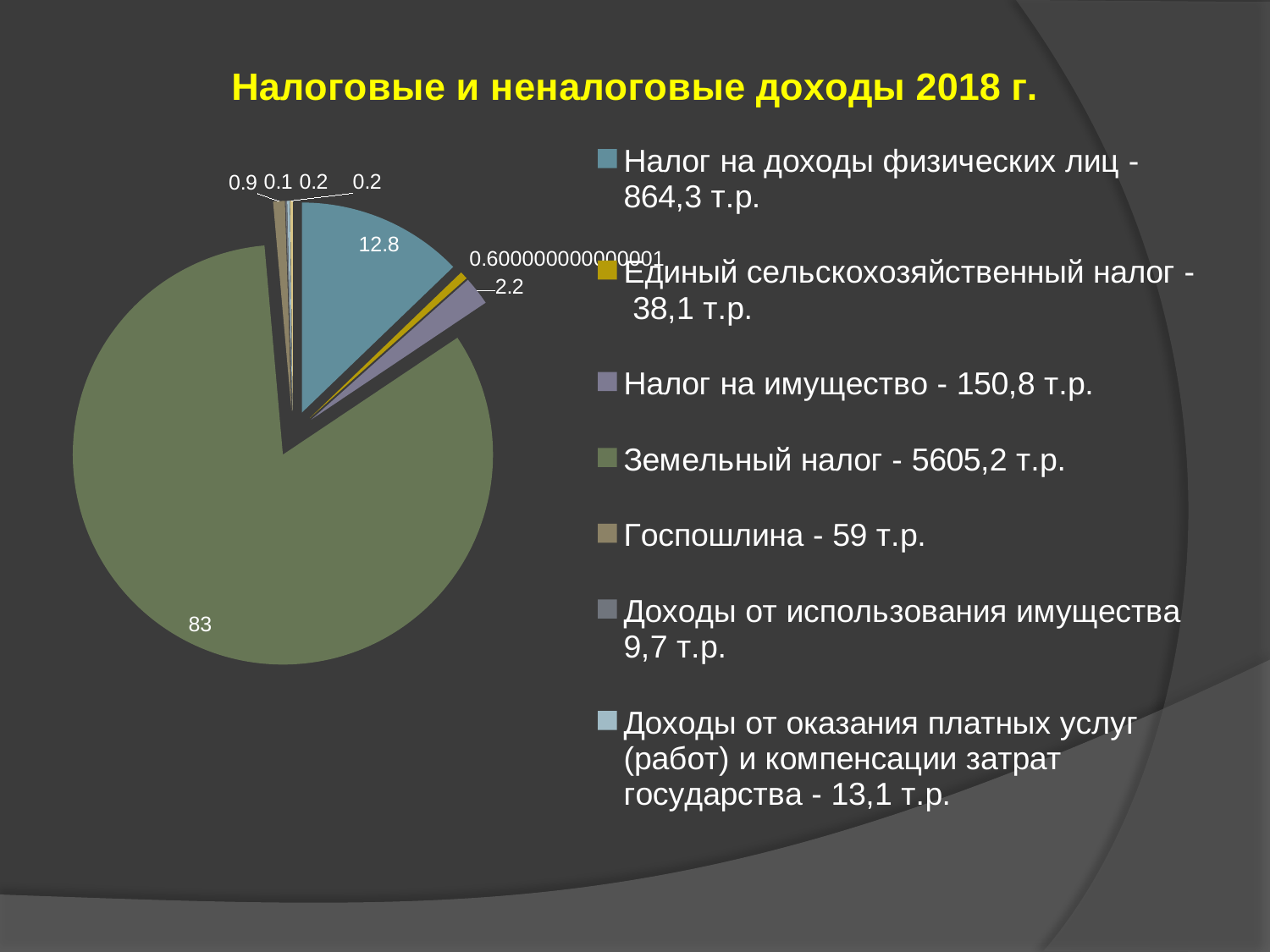
What is the title of the chart on the slide? Налоговые и неналоговые доходы 2018 г. What data label is shown on the slice for Госпошлина? 0.9 According to the legend, what is the amount for Налог на имущество? 150,8 т.р. Which category has the largest slice of the pie? Земельный налог What data label is shown on the slice for Налог на имущество? 2.2 What is the difference between the data labels for Земельный налог (83) and Налог на доходы физических лиц (12.8)? 70.2 What kind of chart is shown on the slide? pie chart According to the legend, what is the amount for Земельный налог? 5605,2 т.р. Which slice is larger: Налог на доходы физических лиц or Налог на имущество? Налог на доходы физических лиц How many entries does the legend list? 7 What data label is shown on the largest slice of the pie? 83 What data label is shown on the slice for Налог на доходы физических лиц? 12.8